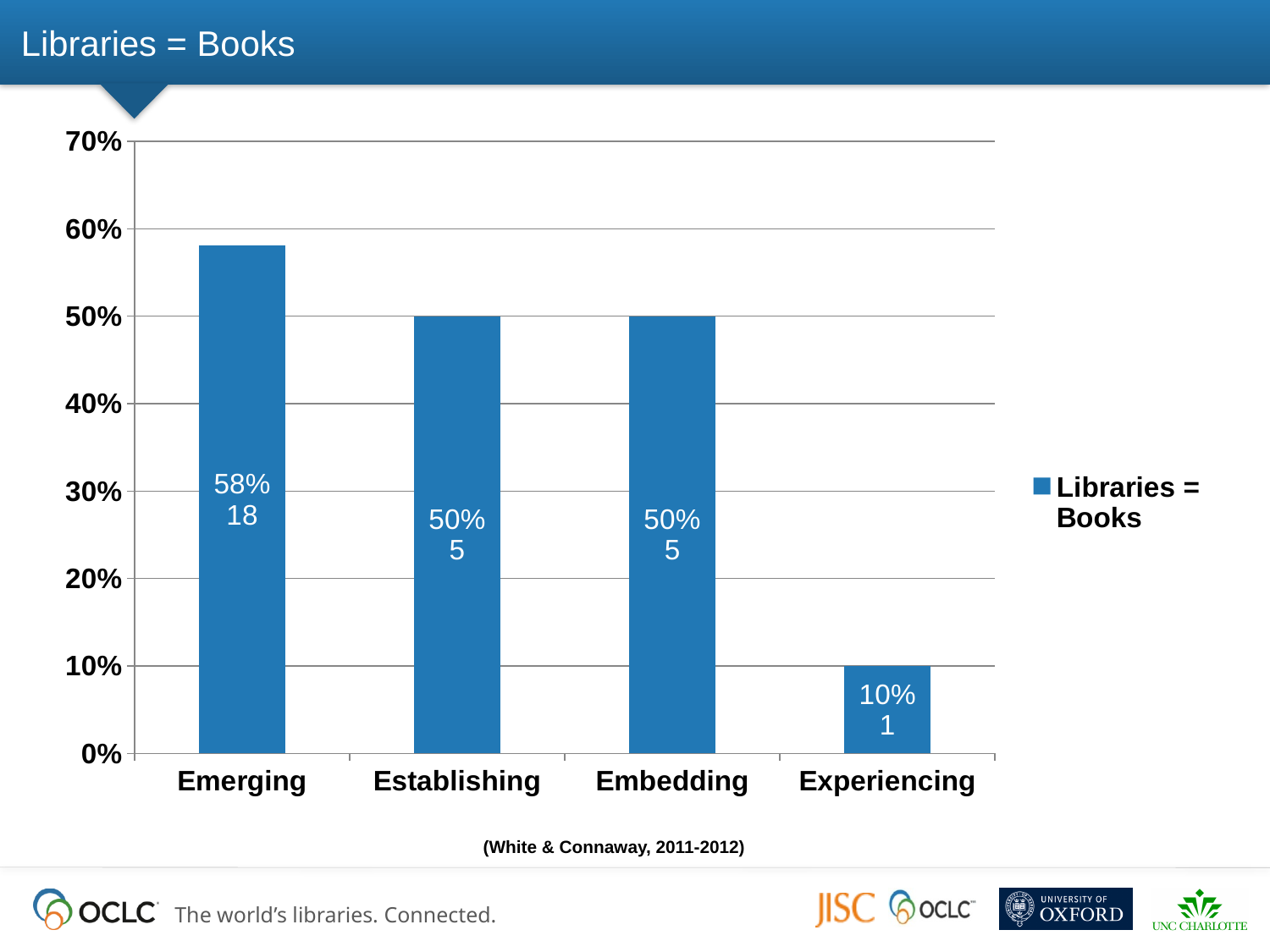
Which category has the lowest percentage? Experiencing What is the legend entry for the series? Libraries = Books Which category has the highest percentage? Emerging What is the title of the slide? Libraries = Books What percentage is shown for the Experiencing category? 10% What kind of chart is shown on the slide? Bar chart How many categories are shown on the x axis? 4 What count is printed on the Establishing bar? 5 What is the difference in percentage points between Emerging and Experiencing? 48 What percentage is shown for the Emerging category? 58% Which is larger, the percentage for Emerging or the percentage for Embedding? Emerging How many series does the legend list? 1